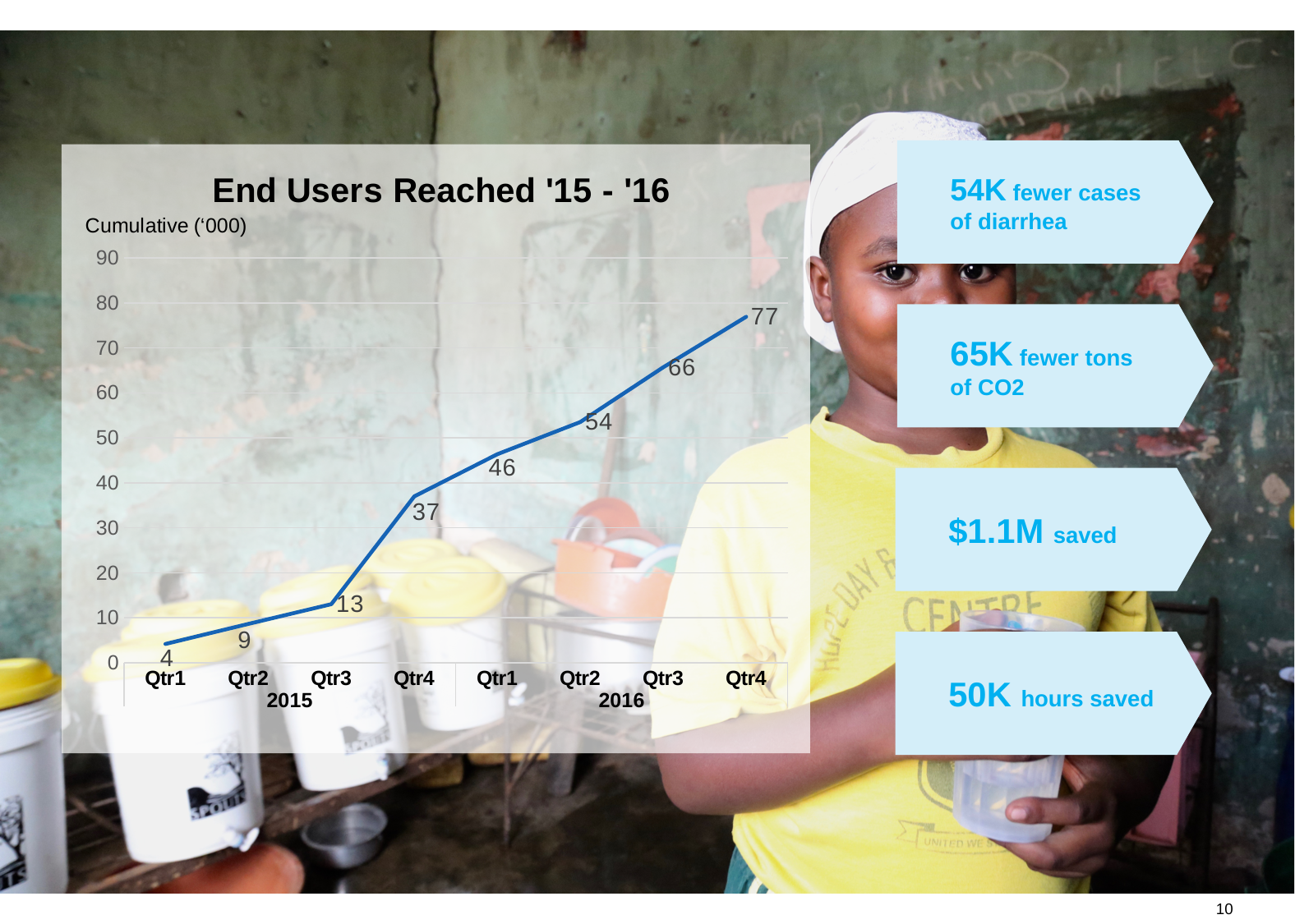
What is the cumulative value for Qtr2 2016? 54 What is the cumulative value for Qtr4 2015? 37 What kind of chart is shown? Line chart Which quarter has the lowest cumulative value? Qtr1 2015 Do the values rise or fall from Qtr1 2015 to Qtr4 2016? Rise What is the difference between the values for Qtr4 2015 and Qtr3 2015? 24 Which quarter has the highest cumulative value? Qtr4 2016 How many data points are plotted on the line? 8 What is the cumulative value for Qtr4 2016? 77 What is the title of the chart? End Users Reached '15 - '16 Which is larger, the value for Qtr3 2016 or the value for Qtr1 2016? Qtr3 2016 What is the cumulative value for Qtr1 2015? 4